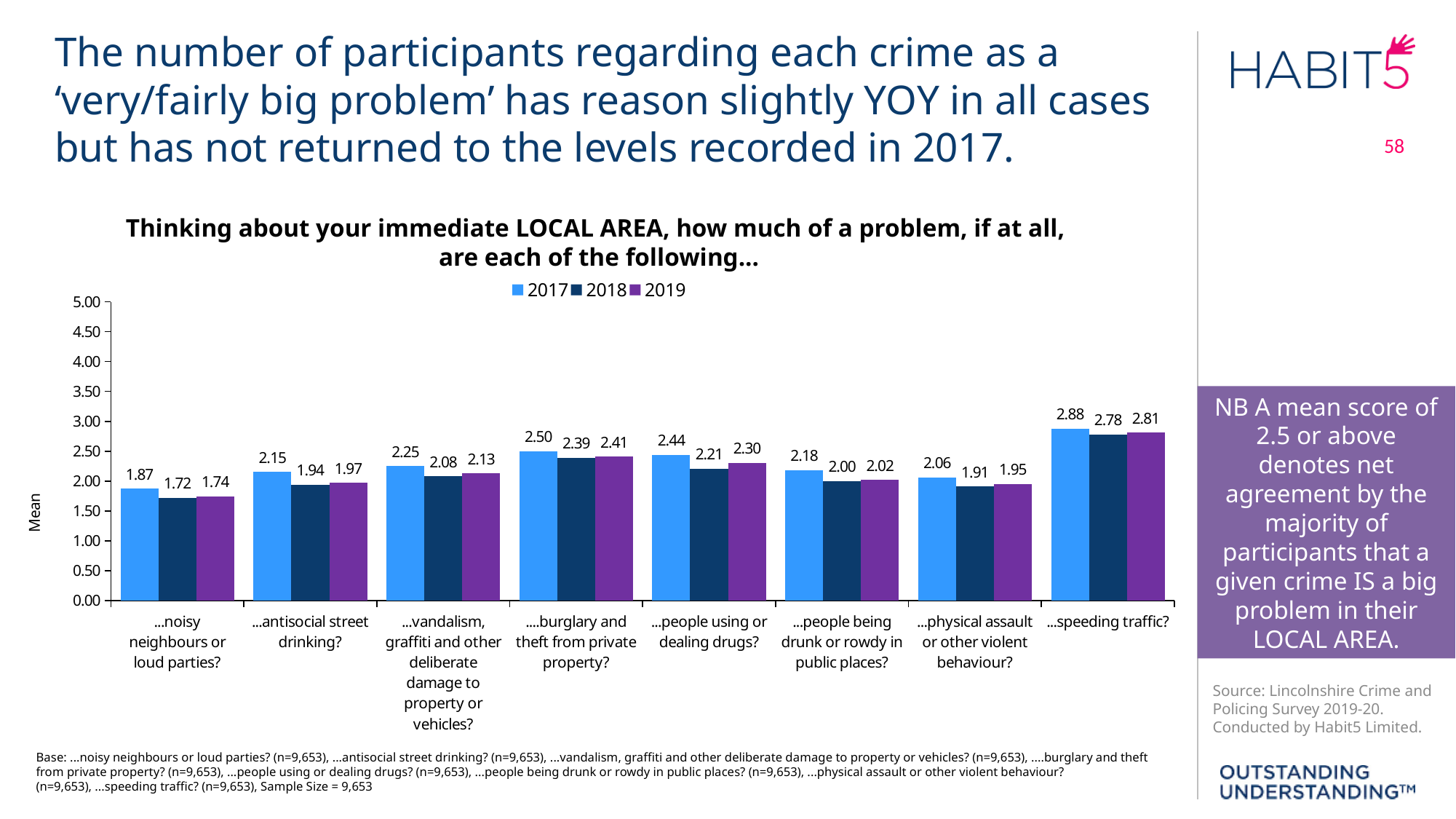
What kind of chart is shown on the slide? Bar chart Which category has the lowest 2017 mean score? ...noisy neighbours or loud parties? Which category has the highest 2019 mean score? ...speeding traffic? What is the label on the y axis of the chart? Mean What is the 2019 mean score for '...people using or dealing drugs?'? 2.30 How many categories are shown on the x axis? 8 What is the 2017 mean score for '...speeding traffic?'? 2.88 Which is larger: the 2018 mean score for '...antisocial street drinking?' or the 2018 mean score for '...physical assault or other violent behaviour?'? ...antisocial street drinking? Is the 2017 mean score for '...speeding traffic?' greater or less than 2.50? greater What is the 2018 mean score for '...noisy neighbours or loud parties?'? 1.72 What is the difference between the 2017 and 2019 mean scores for '....burglary and theft from private property?'? 0.09 How many series does the legend list? 3